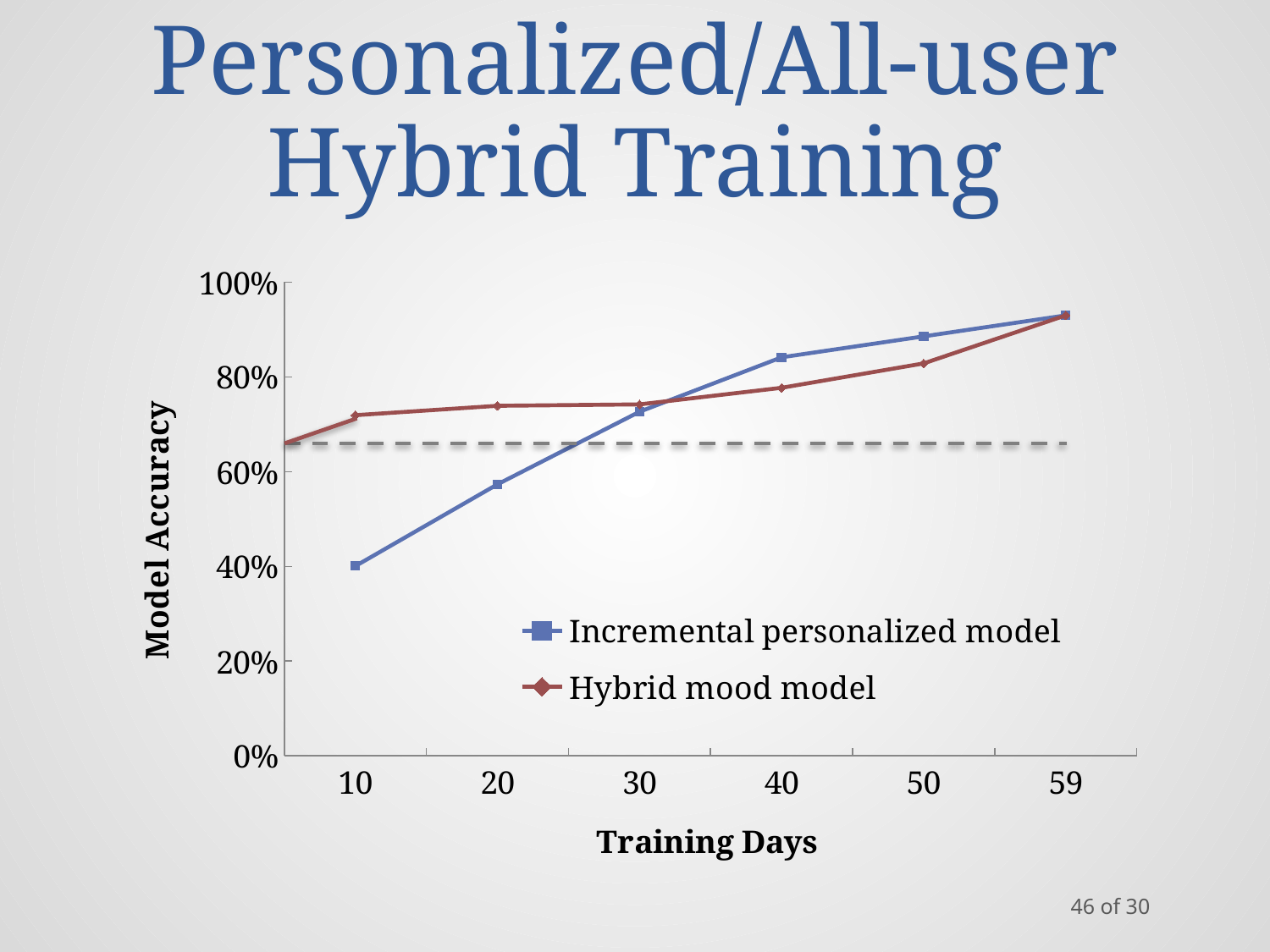
Is the value for the Hybrid mood model at 10 training days greater or less than 60%? greater How many series does the legend list? 2 Is the value for the Incremental personalized model at 20 training days greater or less than 60%? less Does the accuracy of the Incremental personalized model rise or fall as training days increase? rise At which number of training days does the Incremental personalized model reach its lowest accuracy? 10 What kind of chart is shown on the slide? line chart How many training-day points are marked on the x axis? 6 What is the label of the x axis? Training Days At 10 training days, which series has the higher model accuracy? Hybrid mood model Is the value for the Incremental personalized model at 50 training days greater or less than 80%? greater What is the label of the y axis? Model Accuracy At 40 training days, which series has the higher model accuracy? Incremental personalized model